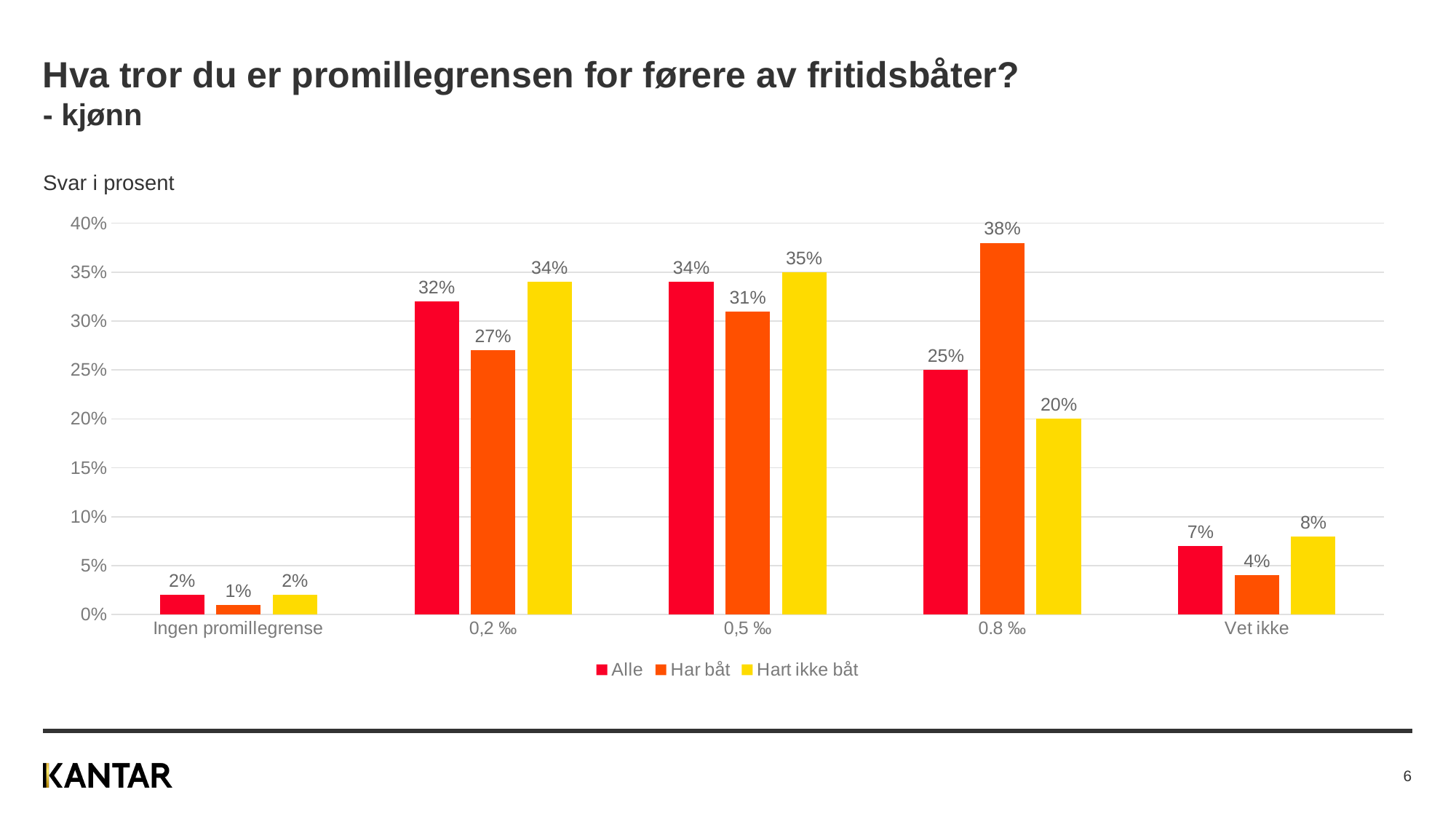
In the '0,2 ‰' category, which is larger: 'Alle' or 'Har båt'? Alle How many categories are shown on the x axis? 5 Which colour represents the 'Hart ikke båt' series? Yellow What is the value for 'Har båt' in the '0.8 ‰' category? 38% How many series does the legend list? 3 Which category has the highest value for the 'Har båt' series? 0.8 ‰ What kind of chart is shown on the slide? Bar chart Which category has the lowest value for the 'Alle' series? Ingen promillegrense What is the difference between 'Har båt' and 'Hart ikke båt' in the '0.8 ‰' category? 18 percentage points What is the value for 'Alle' in the 'Vet ikke' category? 7% What is the title of the chart on the slide? Hva tror du er promillegrensen for førere av fritidsbåter? - kjønn What is the value for 'Hart ikke båt' in the '0,5 ‰' category? 35%